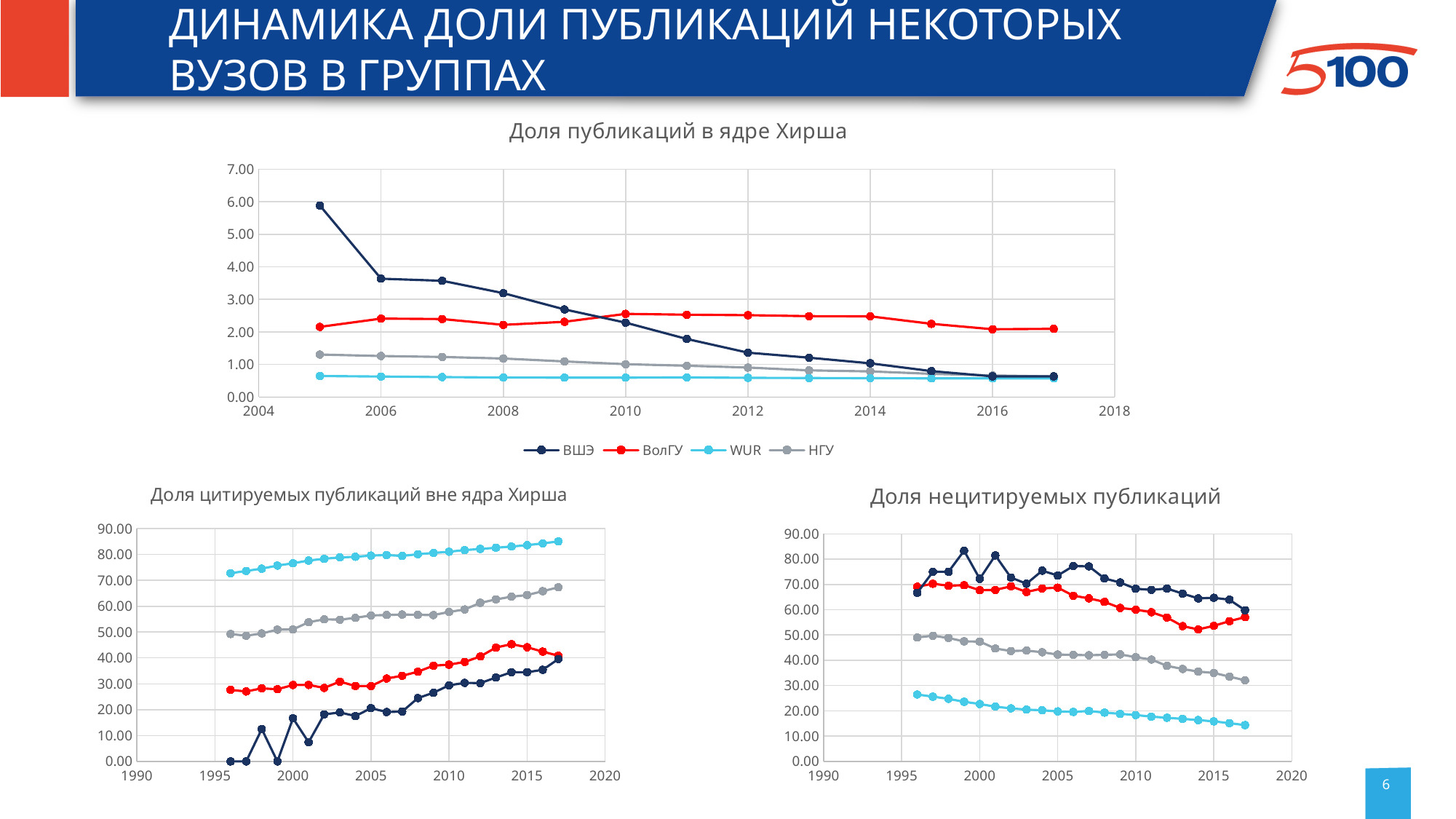
In the top chart "Доля публикаций в ядре Хирша", is the value for ВШЭ in 2005 greater or less than 5.00? greater In the bottom-right chart "Доля нецитируемых публикаций", does the grey line rise or fall over time? fall In the top chart "Доля публикаций в ядре Хирша", which series has the lowest values across the whole period? WUR What are the legend entries of the top chart "Доля публикаций в ядре Хирша"? ВШЭ, ВолГУ, WUR, НГУ In the top chart "Доля публикаций в ядре Хирша", does the ВШЭ series rise or fall from 2005 to 2017? fall What kind of chart is the top chart titled "Доля публикаций в ядре Хирша"? line chart In the top chart "Доля публикаций в ядре Хирша", which series has the highest value in 2005? ВШЭ In the bottom-right chart "Доля нецитируемых публикаций", is the value of the light blue line in 2017 greater or less than 20.00? less How many series does the legend of the top chart "Доля публикаций в ядре Хирша" list? 4 In the top chart "Доля публикаций в ядре Хирша", which is larger in 2017: ВолГУ or ВШЭ? ВолГУ In the bottom-left chart "Доля цитируемых публикаций вне ядра Хирша", is the value of the light blue line in 2017 greater or less than 80.00? greater In the bottom-left chart "Доля цитируемых публикаций вне ядра Хирша", does the light blue line rise or fall over time? rise